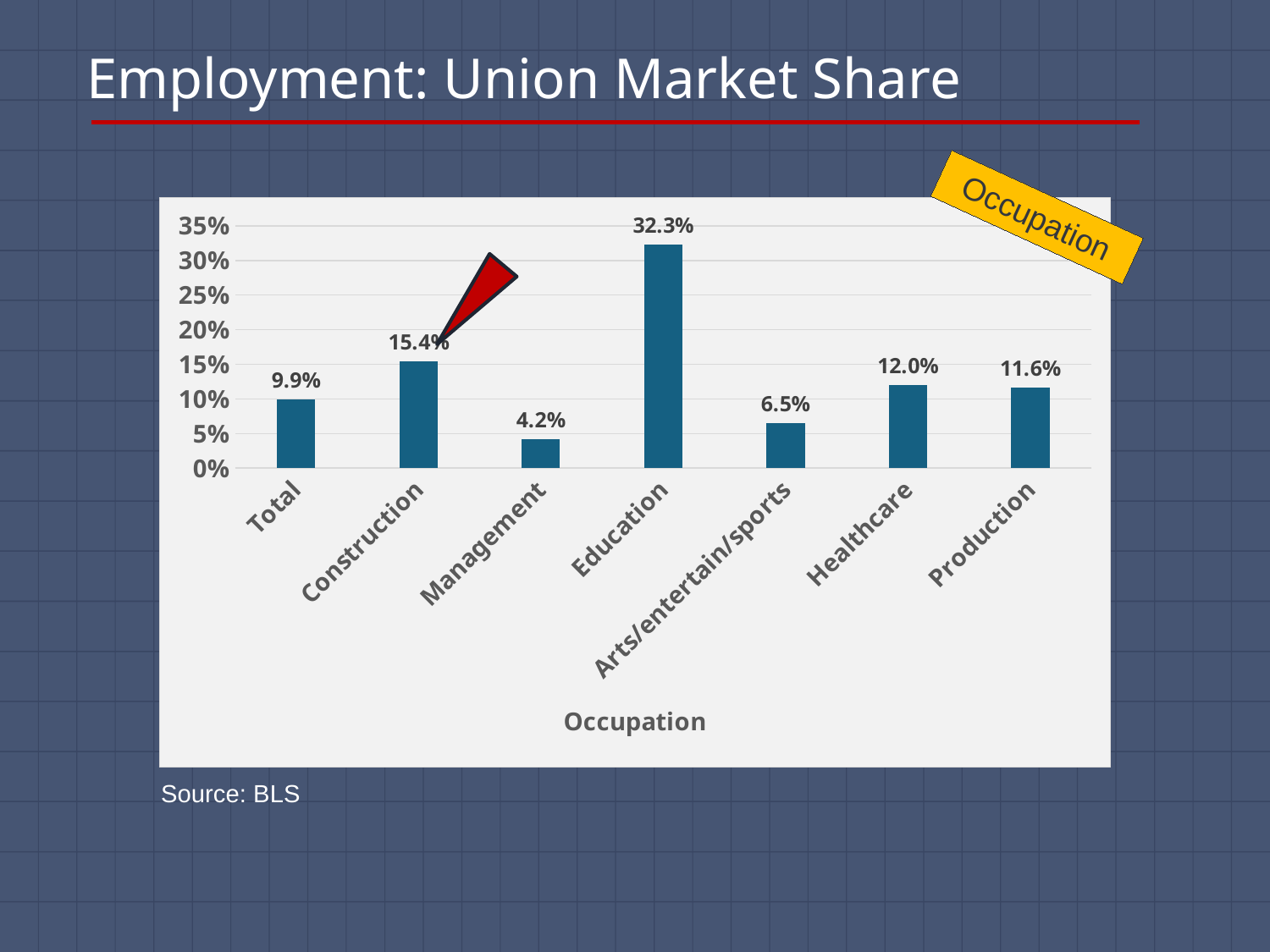
What kind of chart is shown on the slide? bar chart What is the union market share for Education? 32.3% What is the difference between the union market share for Education and for Construction? 16.9% Which has a larger union market share, Healthcare or Production? Healthcare What is the value shown for the Total category? 9.9% What is the label of the horizontal axis of the chart? Occupation What is the union market share for Healthcare? 12.0% Which occupation has the highest union market share? Education How many occupation categories are shown on the chart? 7 Which occupation has the lowest union market share? Management What is the union market share for Construction? 15.4% Is the value for Arts/entertain/sports greater or less than 10%? less